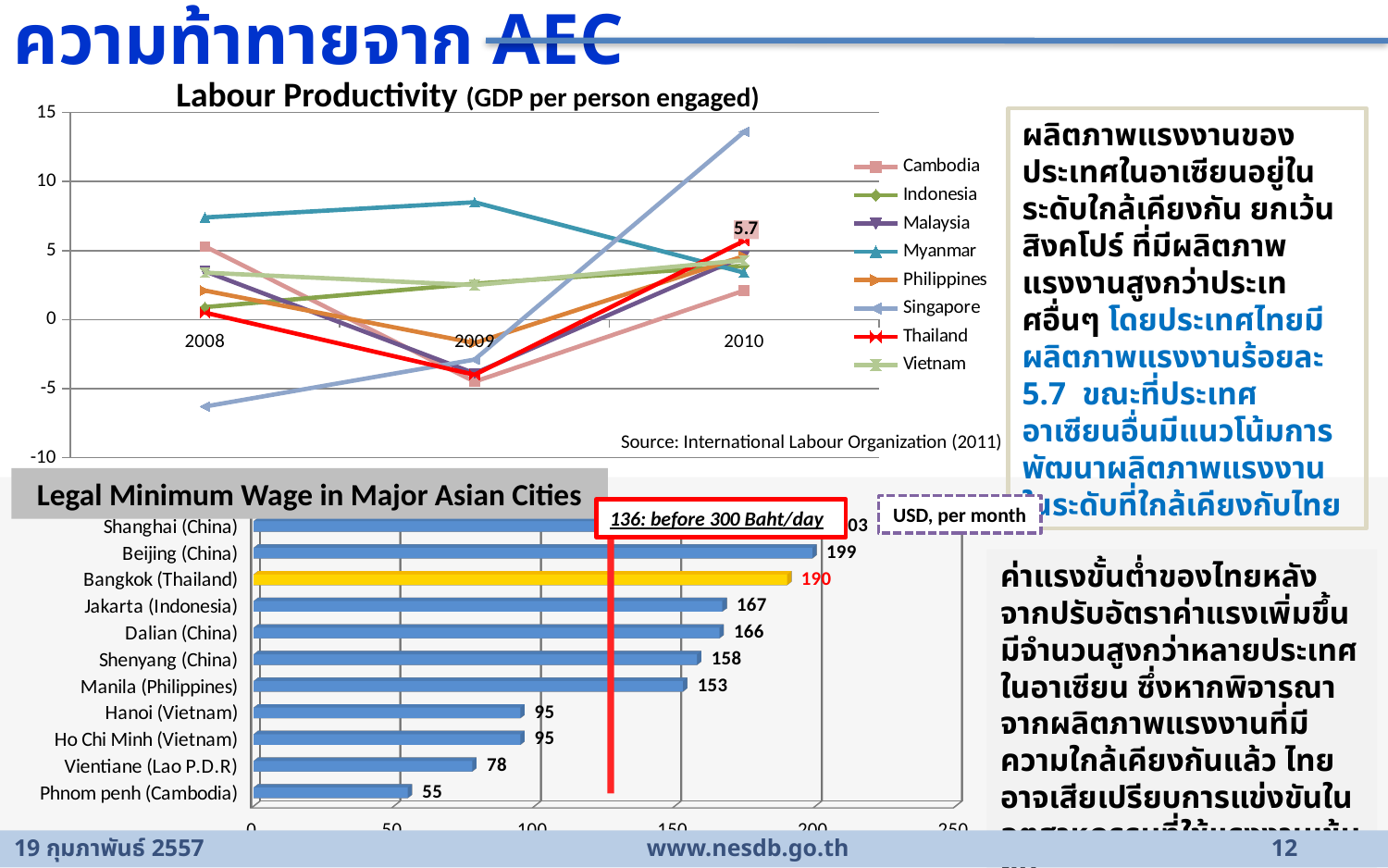
In the 'Legal Minimum Wage in Major Asian Cities' chart, what is the difference between Bangkok (Thailand) and Jakarta (Indonesia)? 23 In the 'Labour Productivity' chart, is the value for Singapore in 2008 greater or less than -5? less In the 'Labour Productivity' chart, does the Singapore line rise or fall from 2008 to 2010? rise In the 'Legal Minimum Wage in Major Asian Cities' chart, what is the value for Bangkok (Thailand)? 190 How many cities are shown in the 'Legal Minimum Wage in Major Asian Cities' chart? 11 How many series does the legend of the 'Labour Productivity' chart list? 8 What kind of chart is the 'Legal Minimum Wage in Major Asian Cities' chart? bar chart What kind of chart is the 'Labour Productivity (GDP per person engaged)' chart? line chart In the 'Legal Minimum Wage in Major Asian Cities' chart, which city has the lowest minimum wage? Phnom penh (Cambodia) In the 'Labour Productivity' chart, is the value for Singapore in 2010 greater or less than 10? greater In the 'Labour Productivity' chart, what is the value for Thailand in 2010? 5.7 In the 'Legal Minimum Wage in Major Asian Cities' chart, which is larger, Hanoi (Vietnam) or Vientiane (Lao P.D.R)? Hanoi (Vietnam)